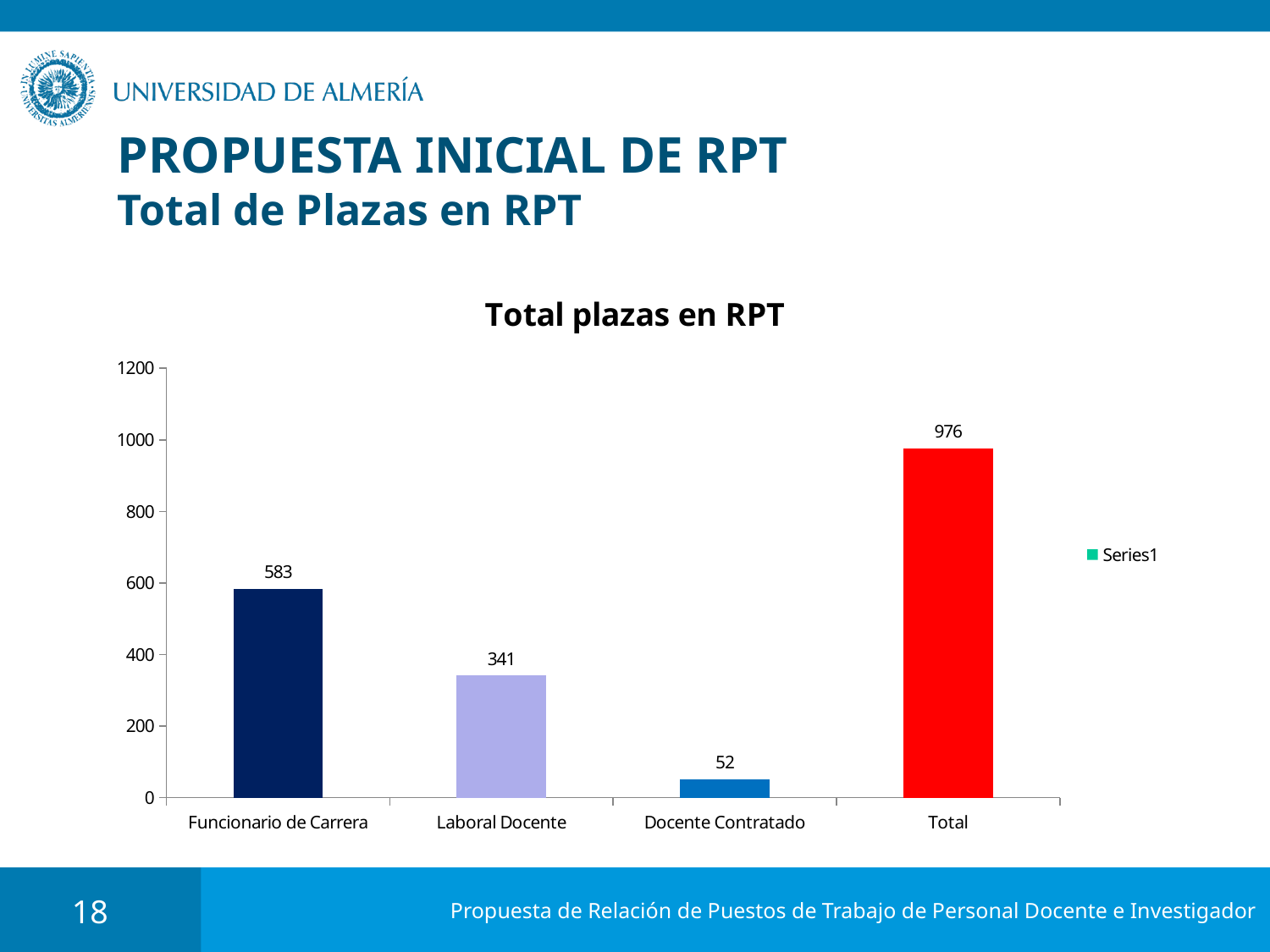
How many categories are shown on the x axis? 4 Which category has the highest value? Total Which category has the lowest value? Docente Contratado Which is larger, Laboral Docente or Docente Contratado? Laboral Docente Is the value for Funcionario de Carrera greater or less than 400? greater What is the value for Total? 976 What is the value for Docente Contratado? 52 What is the value for Funcionario de Carrera? 583 What is the difference between Funcionario de Carrera and Laboral Docente? 242 What is the value for Laboral Docente? 341 What is the title of the chart? Total plazas en RPT What kind of chart is this? bar chart